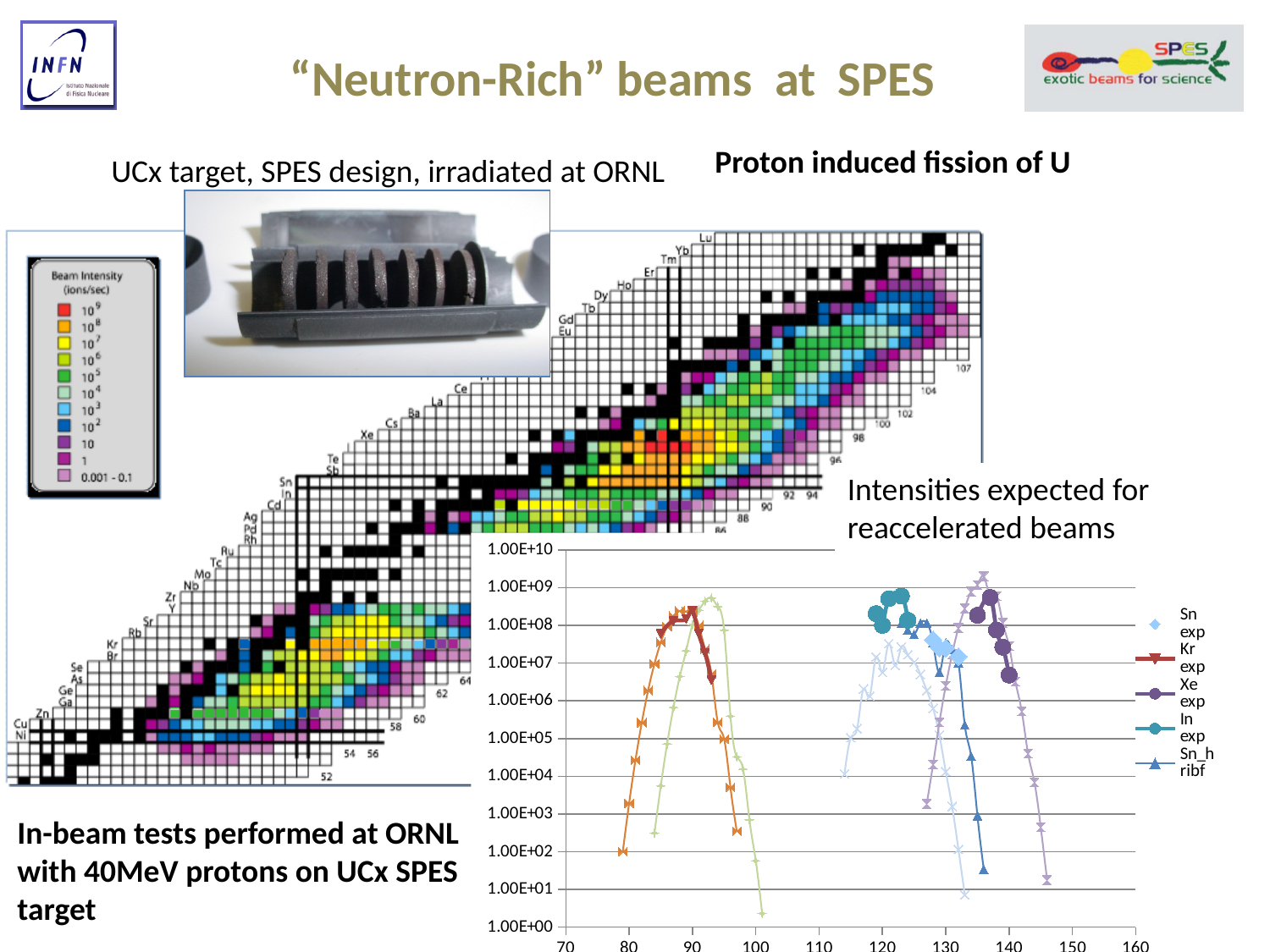
In the intensities chart at the bottom right, is the peak value of the In exp series greater or less than 1.00E+08? greater In the intensities chart at the bottom right, is the peak value of the Xe exp series greater or less than 1.00E+08? greater In the intensities chart at the bottom right, which series reaches a higher peak intensity, Xe exp or Sn exp? Xe exp In the intensities chart at the bottom right, is the peak value of the Kr exp series greater or less than 1.00E+09? less In the intensities chart at the bottom right, which series are listed in the legend? Sn exp, Kr exp, Xe exp, In exp, Sn_h ribf In the intensities chart at the bottom right, what range does the x axis span? 70 to 160 What kind of chart is the plot at the bottom right of the slide showing intensities expected for reaccelerated beams? scatter (line) chart In the intensities chart at the bottom right, what is the highest value shown on the y axis? 1.00E+10 In the intensities chart at the bottom right, which series reaches a higher peak intensity, In exp or Sn_h ribf? In exp In the intensities chart at the bottom right, how many series does the legend list? 5